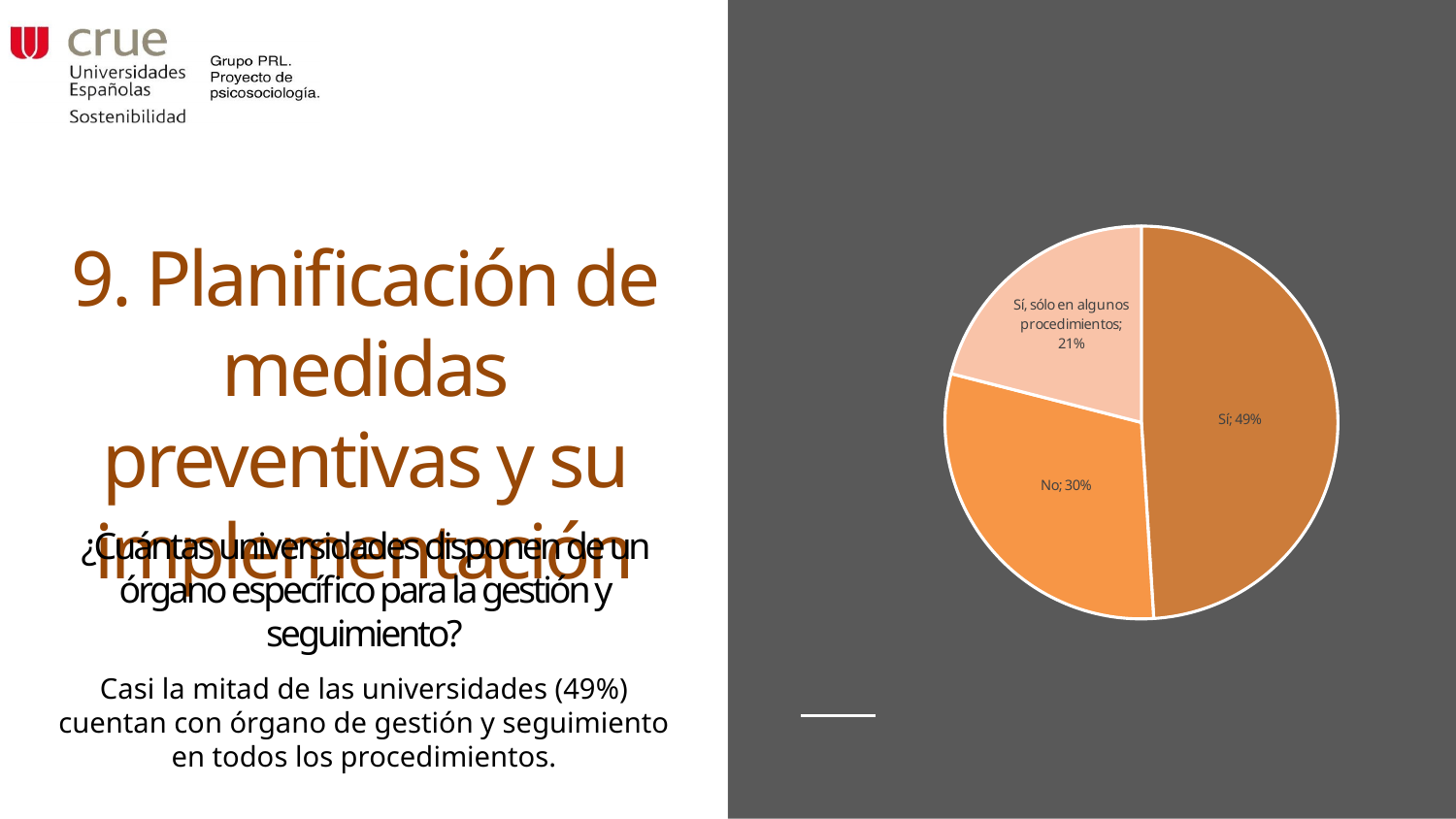
Which slice of the pie chart is the smallest? Sí, sólo en algunos procedimientos What share of the pie does the "Sí" slice represent? 49% Which is larger in the pie chart, the "No" slice or the "Sí, sólo en algunos procedimientos" slice? No What is the difference in percentage points between the "Sí" slice and the "No" slice? 19 What kind of chart is shown on the slide? pie chart Which slice of the pie chart is the largest? Sí Which slice of the pie chart is drawn in the lightest colour? Sí, sólo en algunos procedimientos What is the difference in percentage points between the "No" slice and the "Sí, sólo en algunos procedimientos" slice? 9 What percentage of the pie chart is labelled "Sí"? 49% How many slices does the pie chart have? 3 What percentage of the pie chart is labelled "No"? 30% What percentage of the pie chart is labelled "Sí, sólo en algunos procedimientos"? 21%